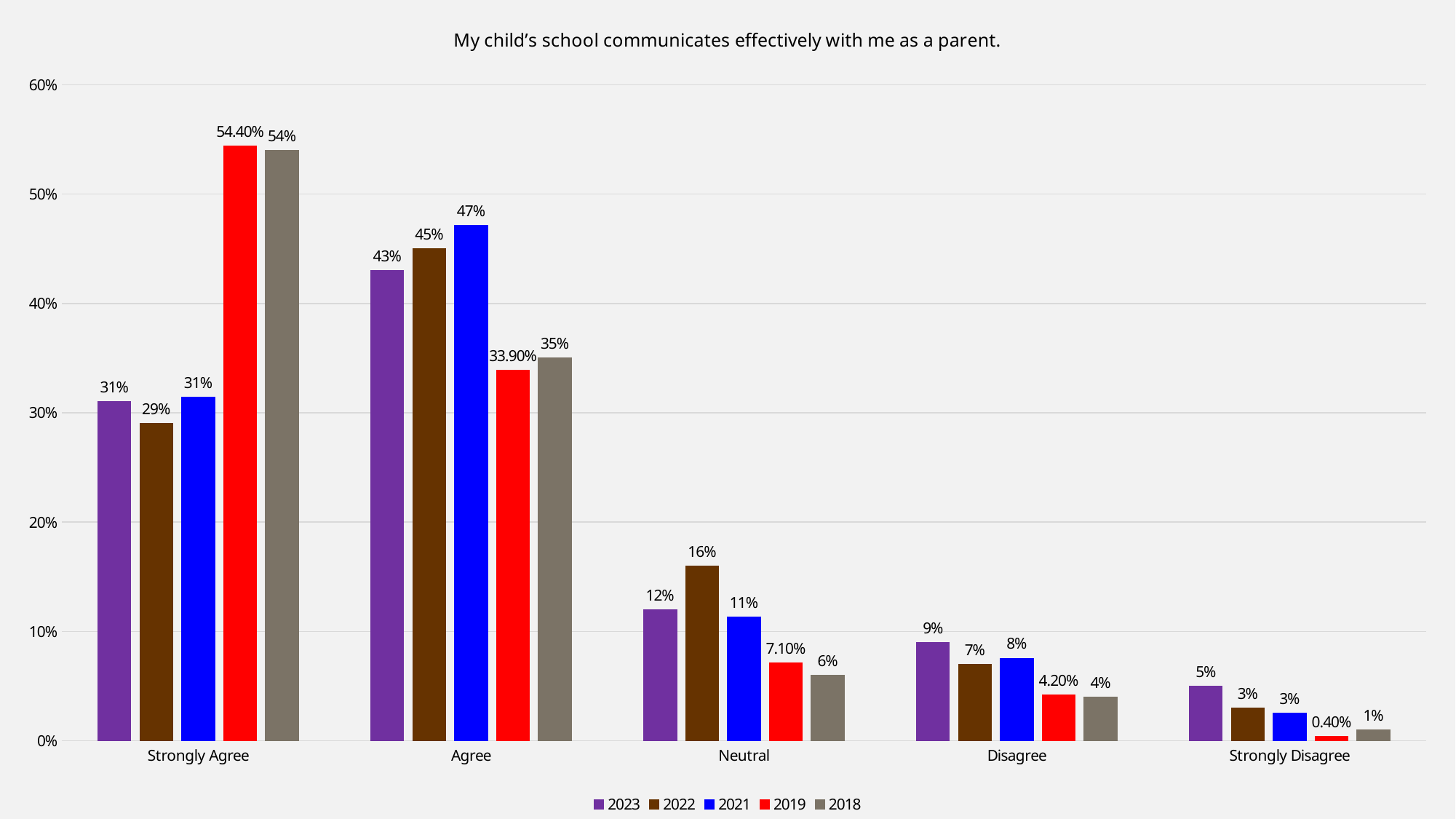
What is the difference between the 2022 and 2018 values in the Neutral category? 10% What is the value for 2019 in the Strongly Disagree category? 0.40% What is the value for 2022 in the Neutral category? 16% How many series does the legend list? 5 Which is larger in the Agree category: the value for 2023 or the value for 2018? 2023 What kind of chart is shown on the slide? Bar chart How many response categories are shown on the x axis? 5 Which year has the lowest value in the Disagree category? 2018 Which year has the highest value in the Strongly Agree category? 2019 What is the value for 2021 in the Agree category? 47% What is the value for 2019 in the Strongly Agree category? 54.40% What is the title of the chart? My child’s school communicates effectively with me as a parent.